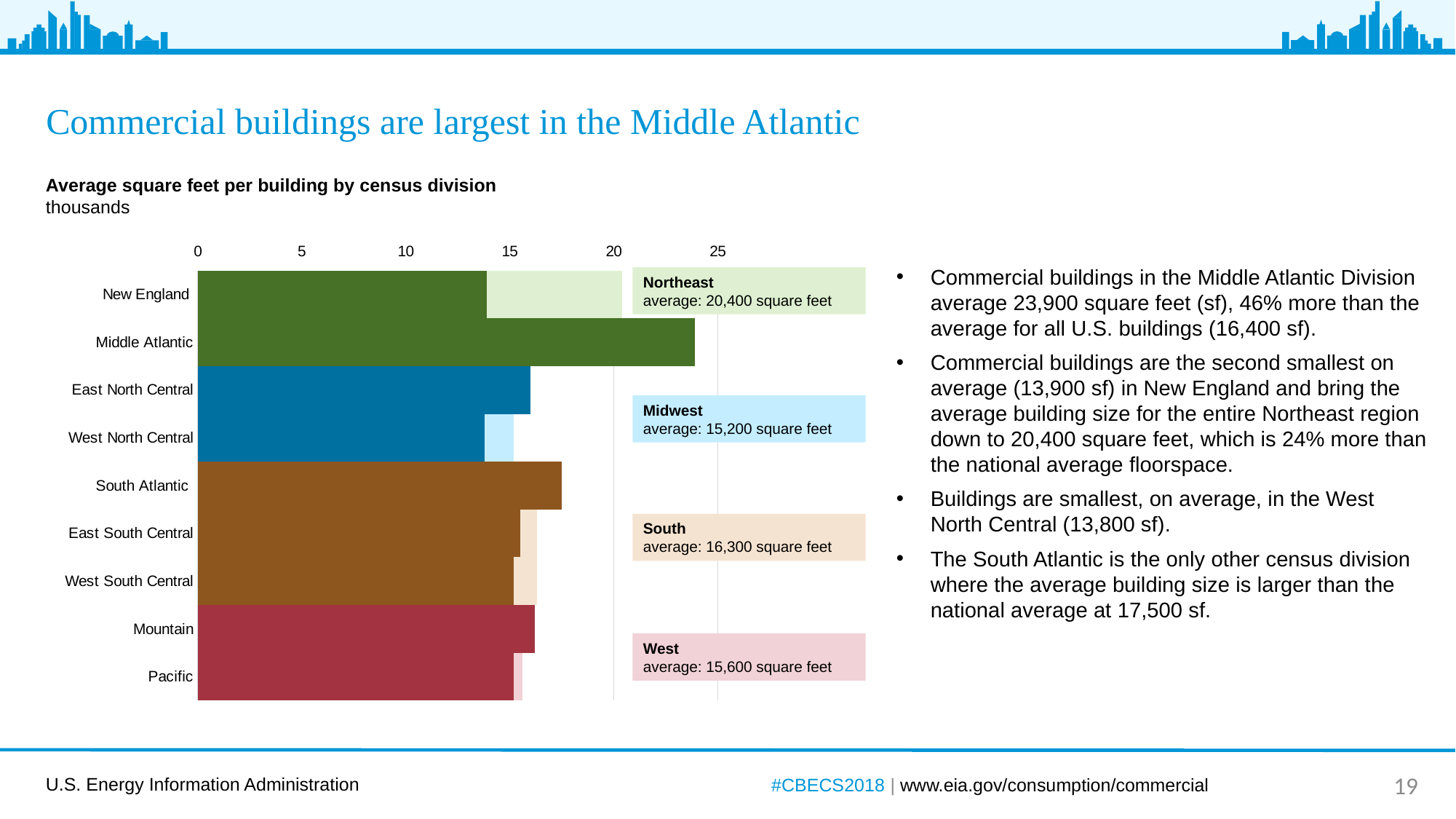
What kind of chart is shown on the slide? bar chart What is the average building size for the West region shown in the chart annotation? 15,600 square feet What is the average building size for the Northeast region shown in the chart annotation? 20,400 square feet Is the value for New England greater or less than 15? less In what units are the chart's values expressed? thousands What is the title of the chart? Average square feet per building by census division How much larger is the Northeast regional average than the Midwest regional average? 5,200 square feet Is the value for Middle Atlantic greater or less than 20? greater What is the average building size for the South region shown in the chart annotation? 16,300 square feet Which census division has the largest average square feet per building? Middle Atlantic What is the average building size for the Midwest region shown in the chart annotation? 15,200 square feet How many census divisions are plotted in the chart? 9